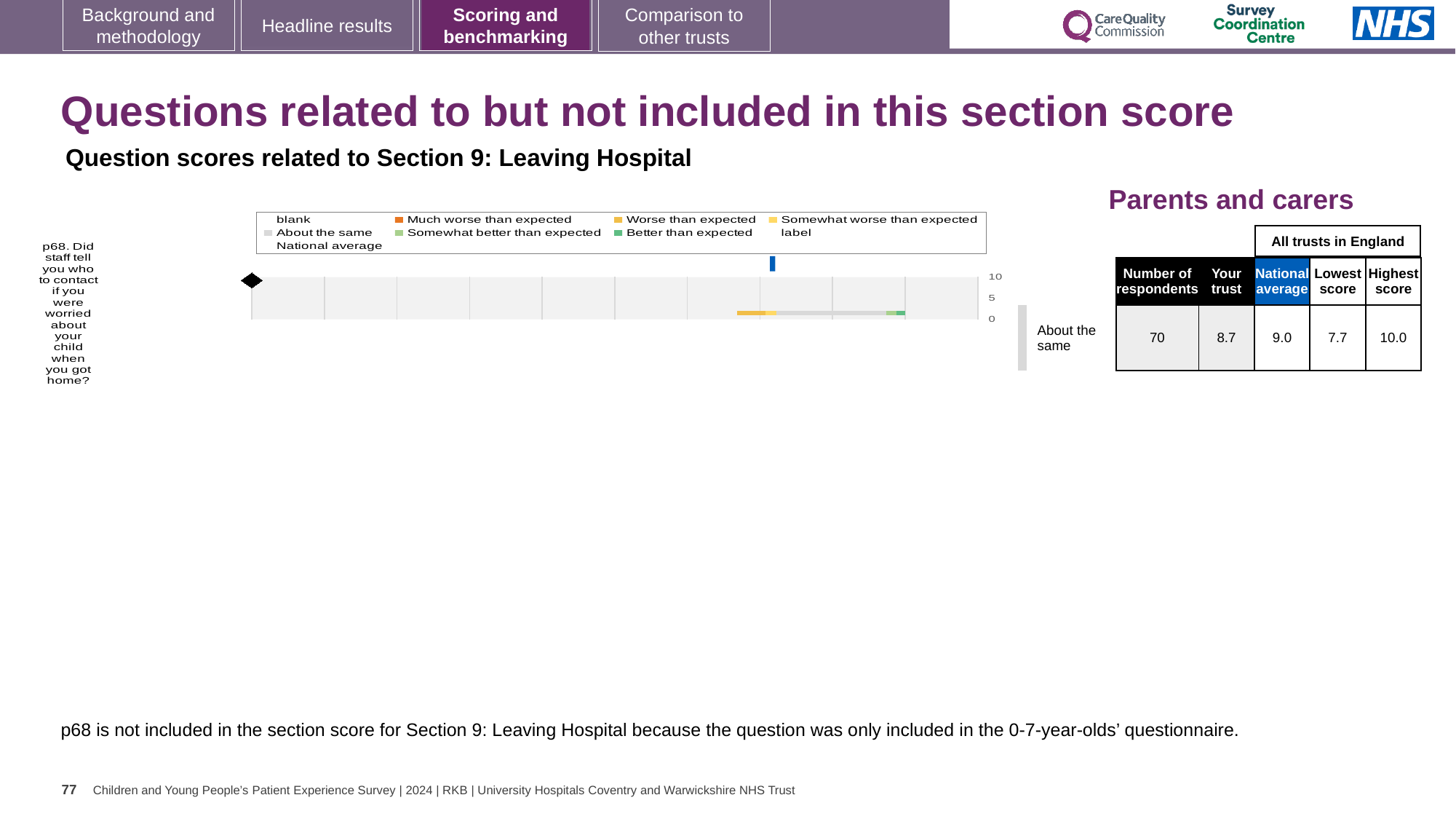
How is the trust's result for p68 categorised relative to expectations? About the same What is the lowest score among all trusts in England for p68? 7.7 What is the national average score for p68? 9.0 How many respondents answered p68? 70 Which is larger for p68, the 'Your trust' score or the national average? National average Which survey question is plotted in the chart? p68. Did staff tell you who to contact if you were worried about your child when you got home? What is the 'Your trust' score for p68? 8.7 What is the maximum value shown on the chart's score axis? 10 What kind of chart is shown on the slide? bar chart What is the difference between the highest and lowest scores for p68? 2.3 What is the highest score among all trusts in England for p68? 10.0 What is the difference between the national average and the 'Your trust' score for p68? 0.3